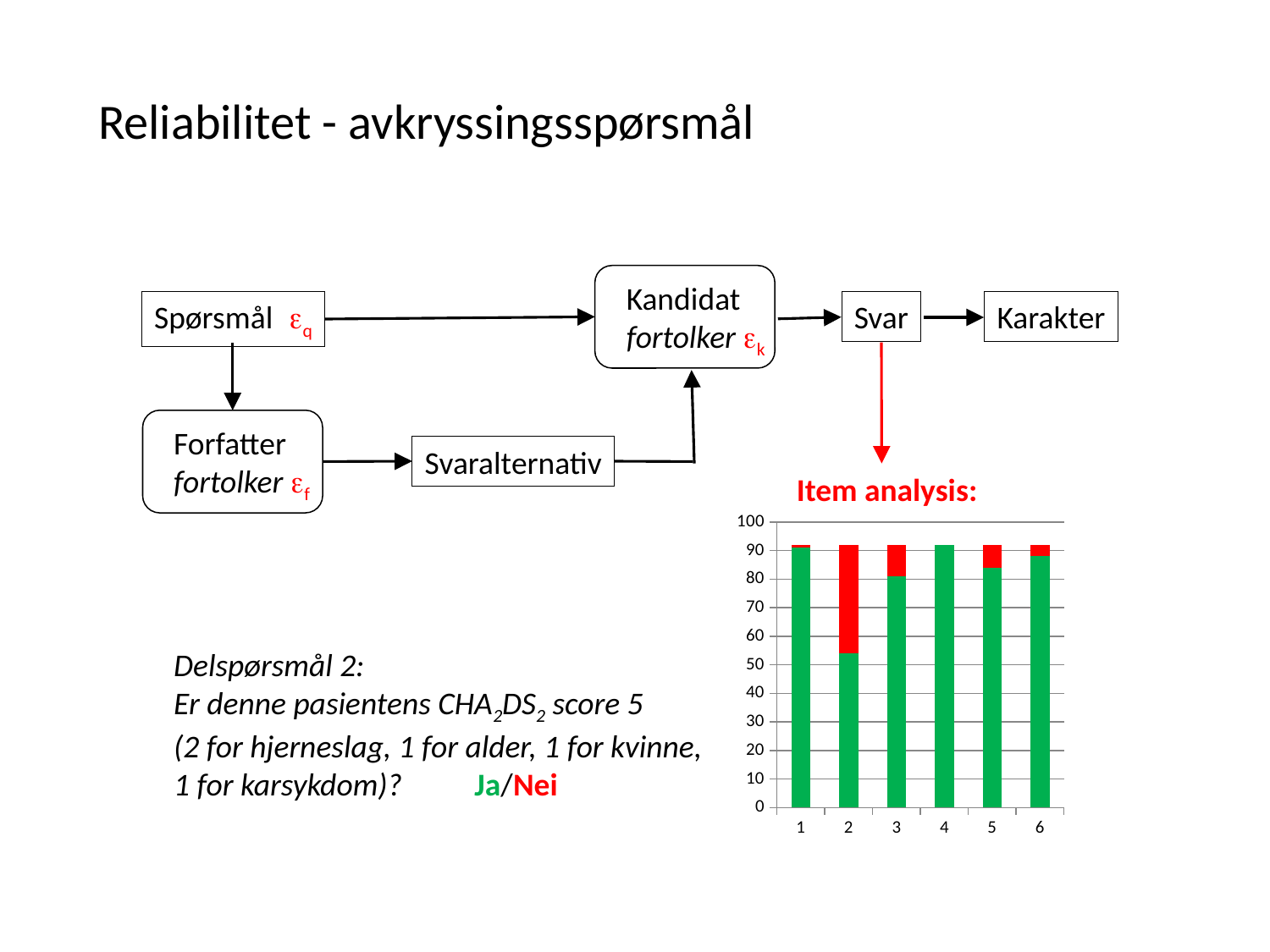
In the Item analysis chart, is the green segment for category 2 greater or less than 60? less In the Item analysis chart, which category has the smallest green segment? 2 In the Item analysis chart, which category shows no visible red segment? 4 How many categories are shown on the x axis of the Item analysis chart? 6 In the Item analysis chart, which category has the largest red segment? 2 What is the title shown above the bar chart? Item analysis: What kind of chart is shown under "Item analysis:"? bar chart In the Item analysis chart, is the green segment for category 6 greater or less than 80? greater In the Item analysis chart, is the green segment for category 5 greater or less than 70? greater In the Item analysis chart, which has the larger green segment, category 2 or category 3? category 3